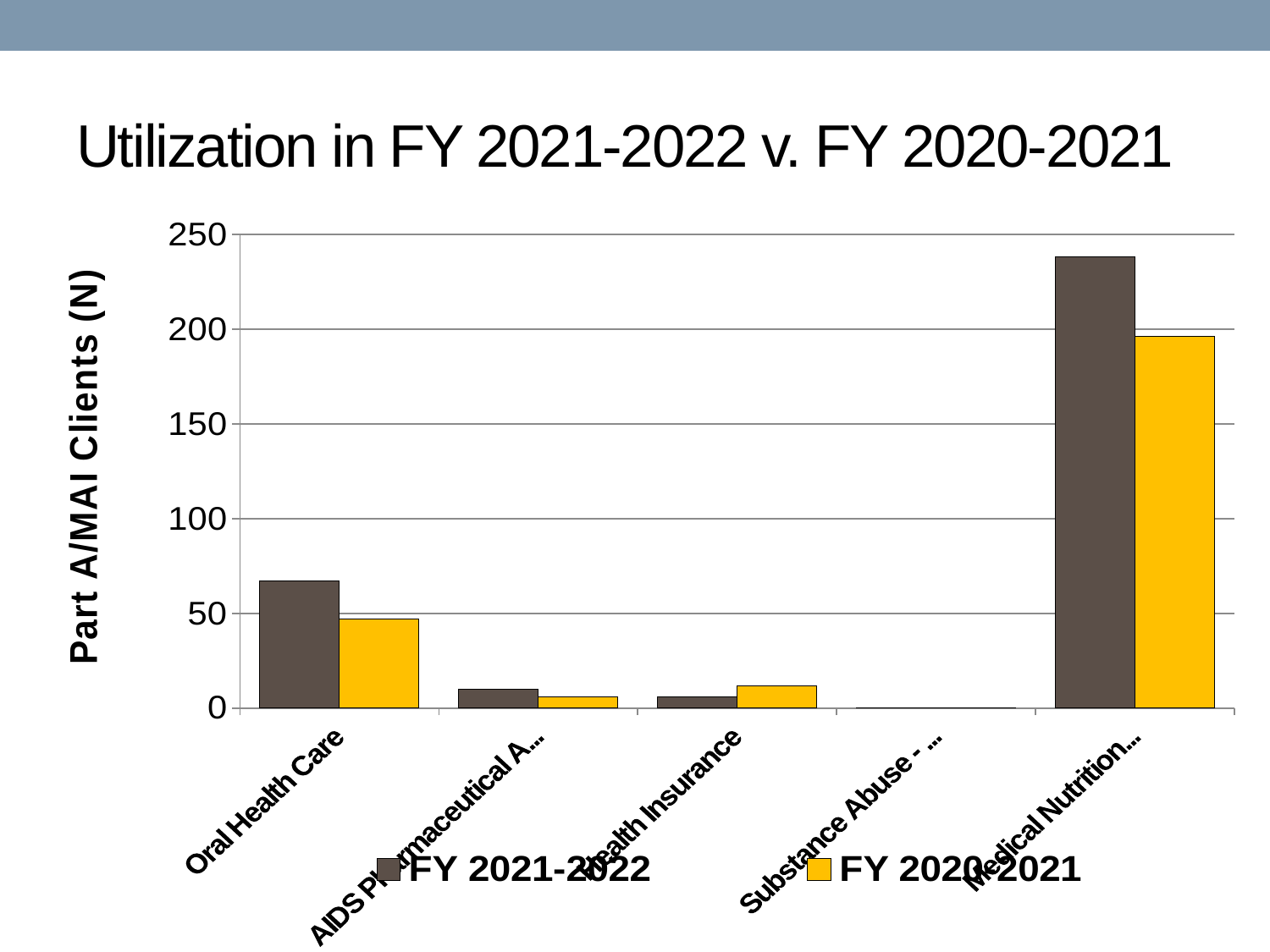
Which category has the highest value for FY 2021-2022? Medical Nutrition What is the title of the chart? Utilization in FY 2021-2022 v. FY 2020-2021 What is the label on the vertical axis? Part A/MAI Clients (N) Is the FY 2021-2022 value for Medical Nutrition greater or less than 200? greater Is the FY 2020-2021 value for Oral Health Care greater or less than 50? less Which category has the lowest values in both fiscal years? Substance Abuse For Oral Health Care, which series is larger, FY 2021-2022 or FY 2020-2021? FY 2021-2022 How many categories are shown on the x axis? 5 Which category has the highest value for FY 2020-2021? Medical Nutrition How many series does the legend list? 2 What kind of chart is shown on the slide? bar chart For Health Insurance, which series is larger, FY 2021-2022 or FY 2020-2021? FY 2020-2021